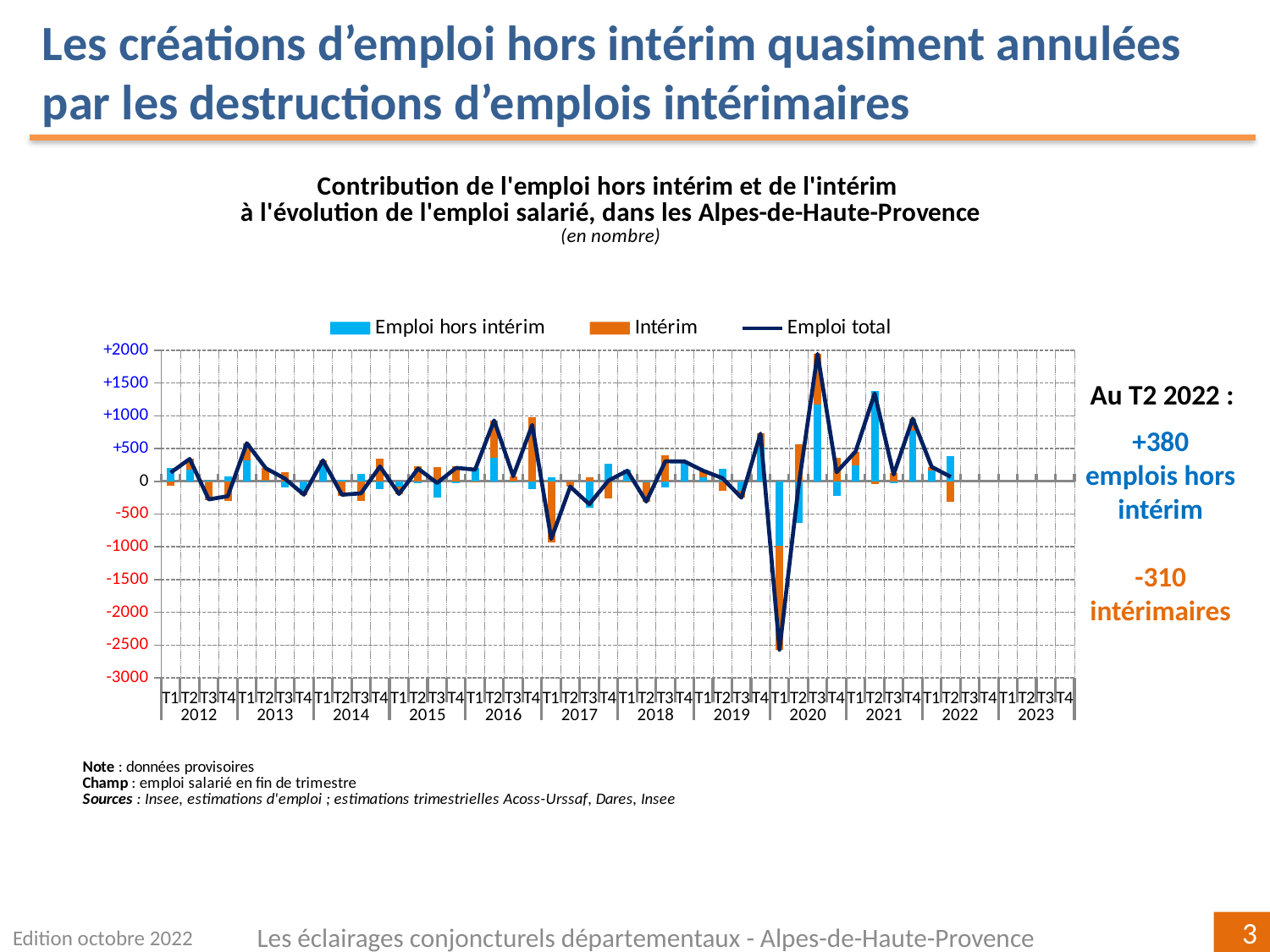
How many years are labelled along the x axis of the chart? 12 What is the value for 'Intérim' at T2 2022? -310 What is the value for 'Emploi hors intérim' at T2 2022? +380 In which quarter does 'Emploi total' reach its lowest value? T1 2020 What is the difference between the 'Emploi hors intérim' value (+380) and the 'Intérim' value (-310) at T2 2022? 690 What kind of chart is shown on the slide? Combined bar and line chart Is the value of 'Emploi total' at T1 2020 greater or less than -2000? less Is the value of 'Intérim' at T1 2020 greater or less than -1000? less How many series does the chart legend list? 3 In which quarter does 'Emploi total' reach its highest value? T3 2020 Is the value of 'Emploi total' at T2 2020 greater or less than +1500? less Which colour represents the 'Intérim' series in the chart? Orange